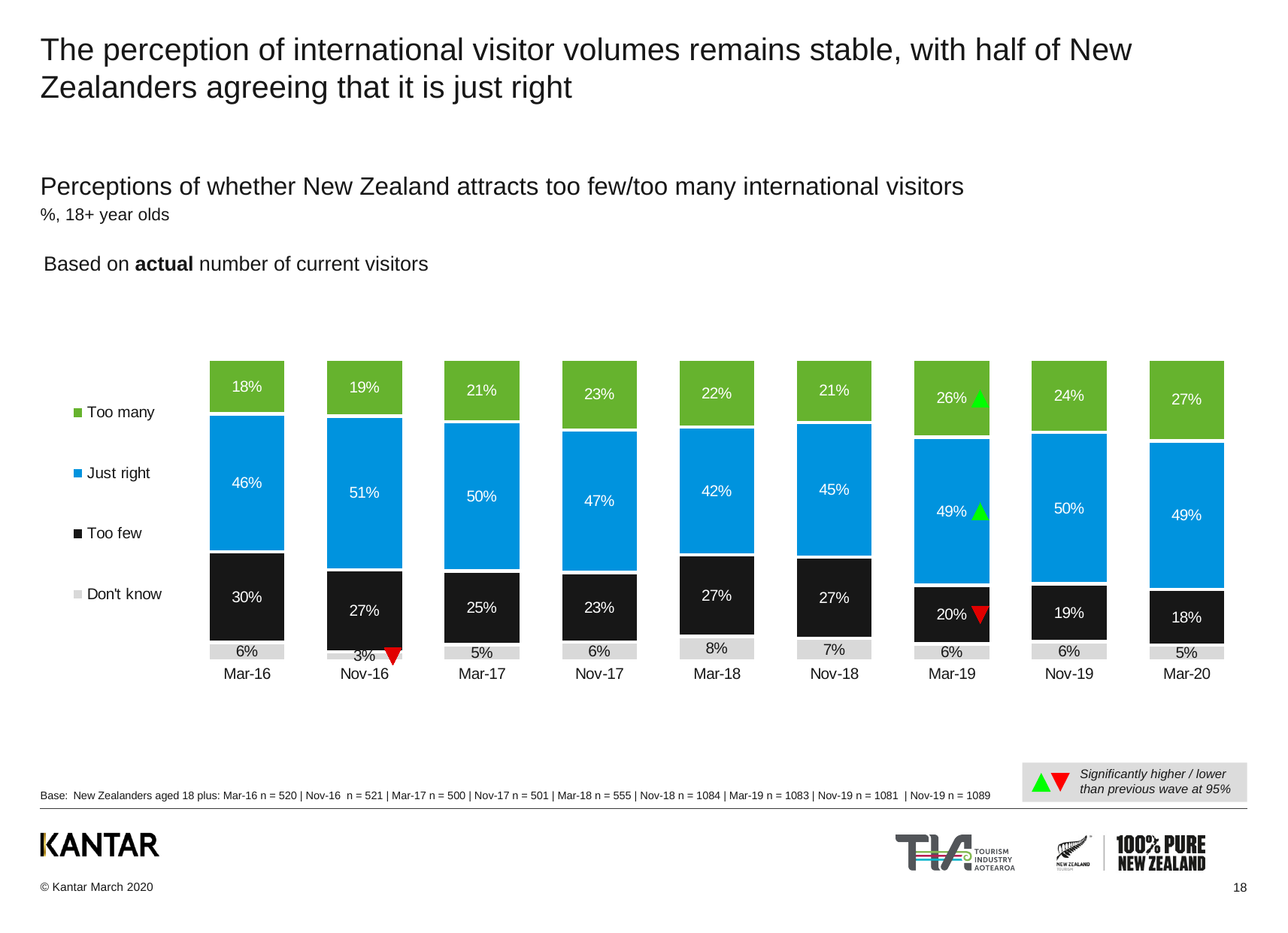
How many series does the legend list? 4 What colour represents 'Just right' in the chart? Blue What kind of chart is shown on the slide? Stacked bar chart What is the 'Too few' value for Mar-16? 30% What percentage of respondents said 'Just right' in Mar-20? 49% Does the 'Too many' share rise or fall from Mar-16 to Mar-20? Rise By how many percentage points did the 'Too few' share fall from Mar-16 to Mar-20? 12 percentage points What is the total of the Mar-16 stacked bar? 100% In which wave is the 'Don't know' share lowest? Nov-16 How many survey waves are shown on the x axis? 9 In which wave is the 'Just right' share highest? Nov-16 Which wave has the larger 'Just right' share, Nov-16 or Mar-18? Nov-16